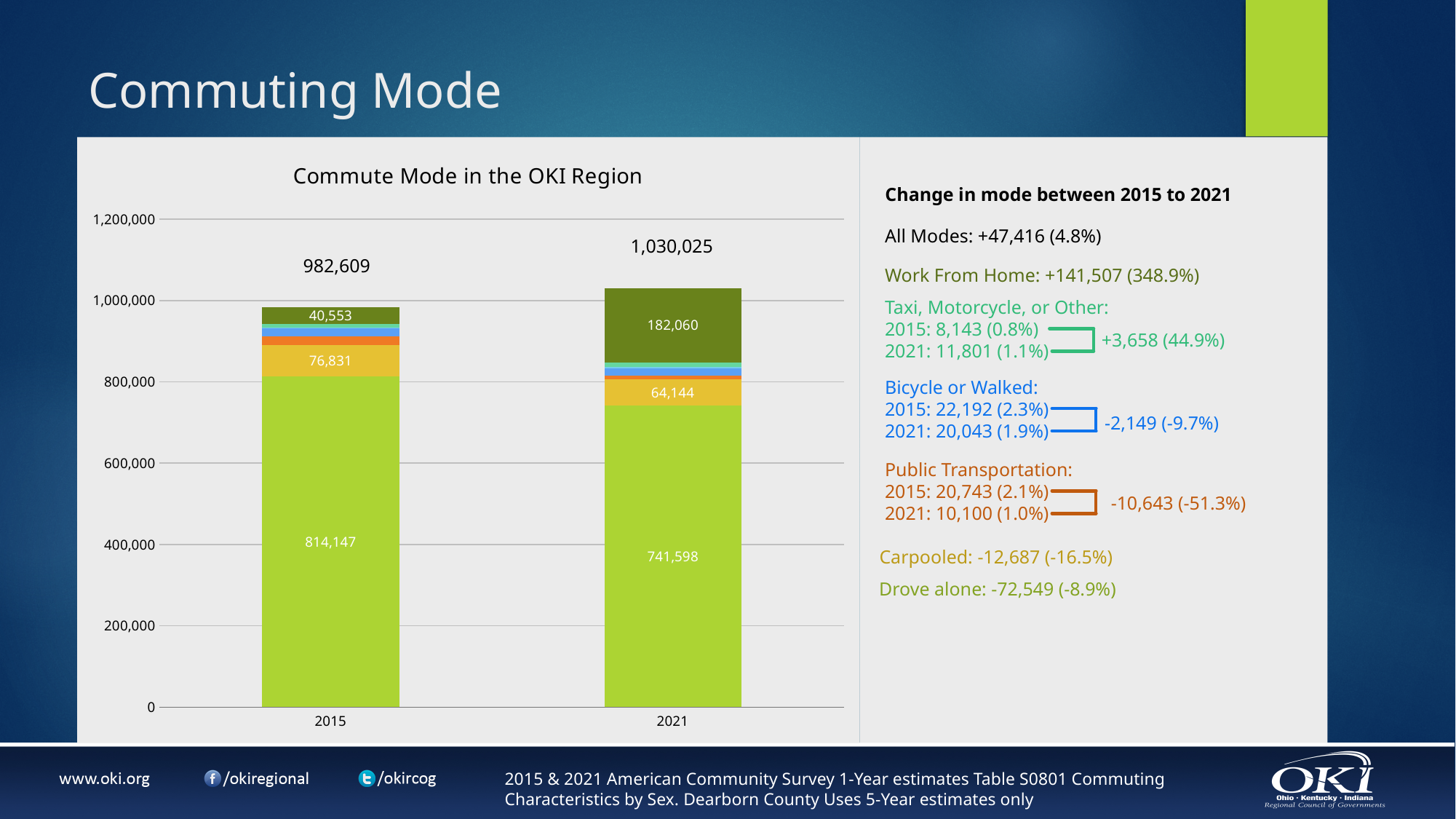
What type of chart is used to show Commute Mode in the OKI Region? Stacked bar chart Does the total number of commuters rise or fall from 2015 to 2021? Rise What is the total value printed above the 2021 bar? 1,030,025 By how much does the 2021 bar total exceed the 2015 bar total? 47,416 What is the total value printed above the 2015 bar in the Commute Mode in the OKI Region chart? 982,609 What is the difference between the dark-green top segment in 2021 (182,060) and in 2015 (40,553)? 141,507 How many bars (years) are shown in the chart? 2 What is the value of the large light-green bottom segment of the 2015 bar? 814,147 What is the value of the large light-green bottom segment of the 2021 bar? 741,598 Which year has the higher total commuters, 2015 or 2021? 2021 What is the value of the yellow segment in the 2015 bar? 76,831 What is the value of the dark-green top segment in the 2021 bar? 182,060